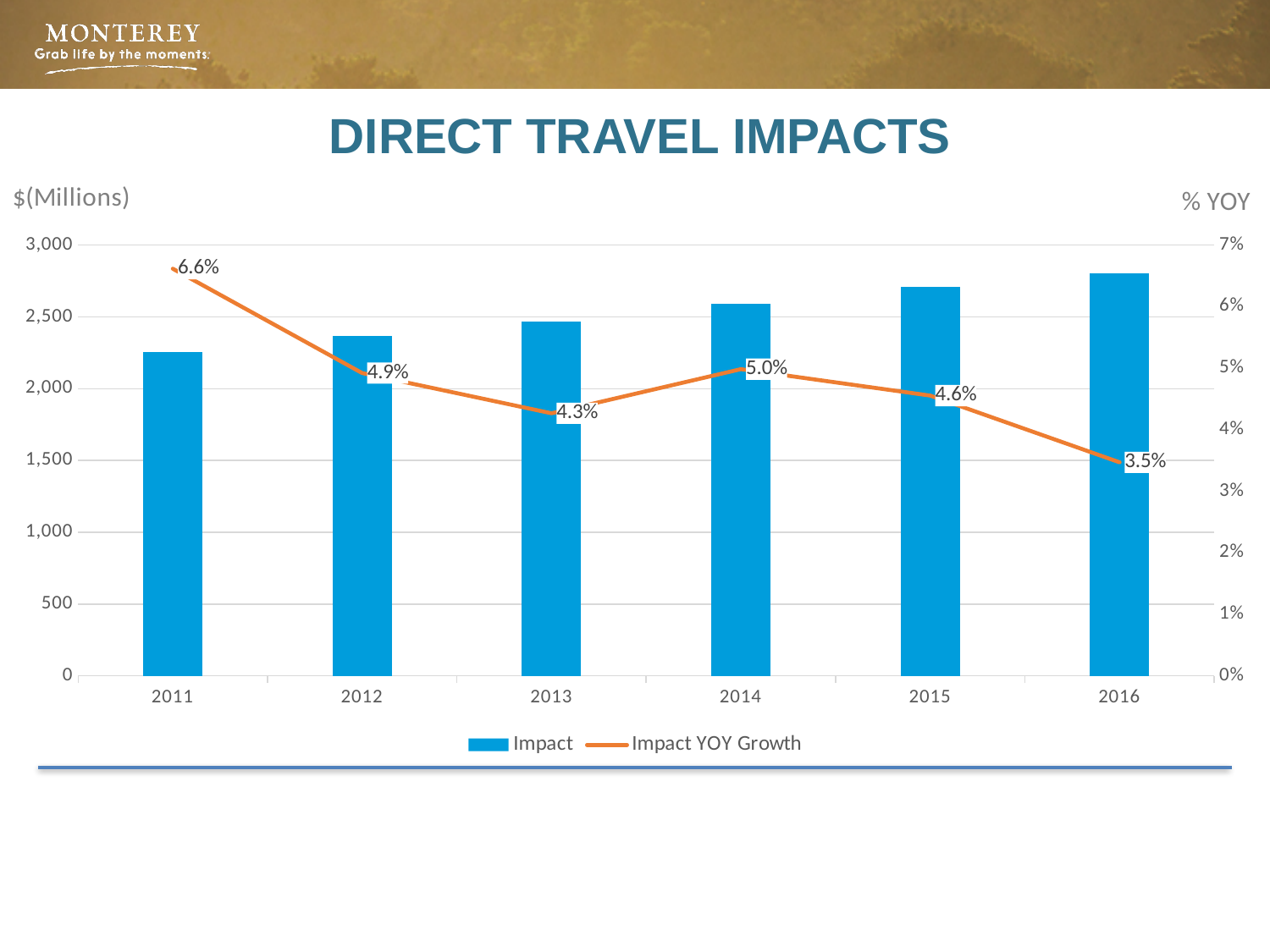
How many years are shown on the x axis? 6 Which year has the lowest Impact YOY Growth? 2016 Do the Impact bars rise or fall from 2011 to 2016? rise By how many percentage points does the Impact YOY Growth in 2011 exceed that in 2016? 3.1 percentage points Which year has the larger Impact YOY Growth, 2013 or 2014? 2014 What is the Impact YOY Growth value for 2016? 3.5% What is the Impact YOY Growth value for 2014? 5.0% Which year has the highest Impact YOY Growth? 2011 How many series does the legend list? 2 Is the Impact value for 2011 greater or less than 2,000? greater What is the Impact YOY Growth value for 2011? 6.6% Is the Impact value for 2016 greater or less than 2,500? greater